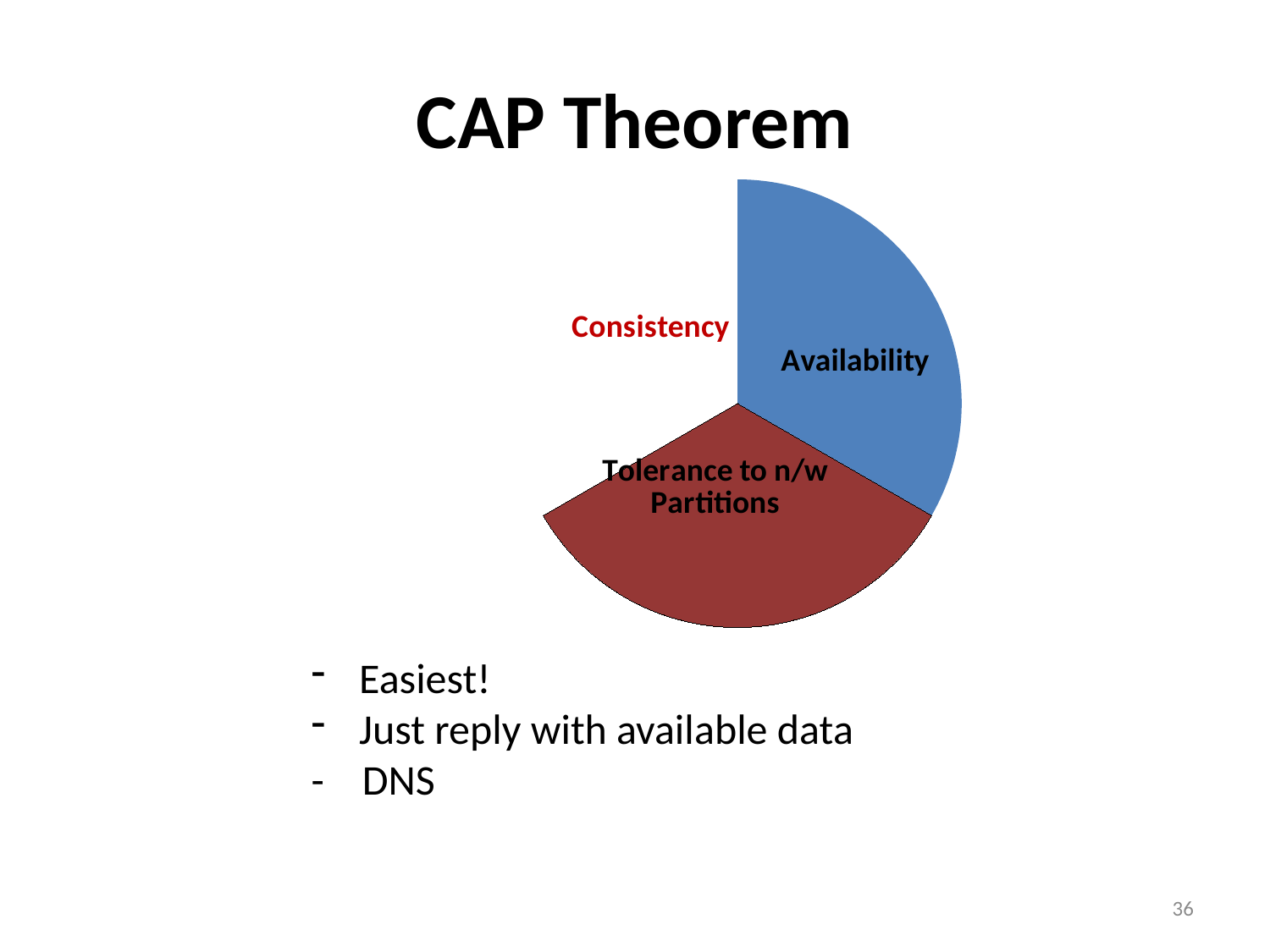
Which category does the dark red slice of the pie chart represent? Tolerance to n/w Partitions What kind of chart is shown on the slide? pie chart What is the title of the slide containing the pie chart? CAP Theorem How many categories are labelled on the pie chart? 3 What colour is the Availability slice of the pie chart? blue How many slices of the pie chart are filled with colour? 2 Which category label is shown in red text on the pie chart? Consistency